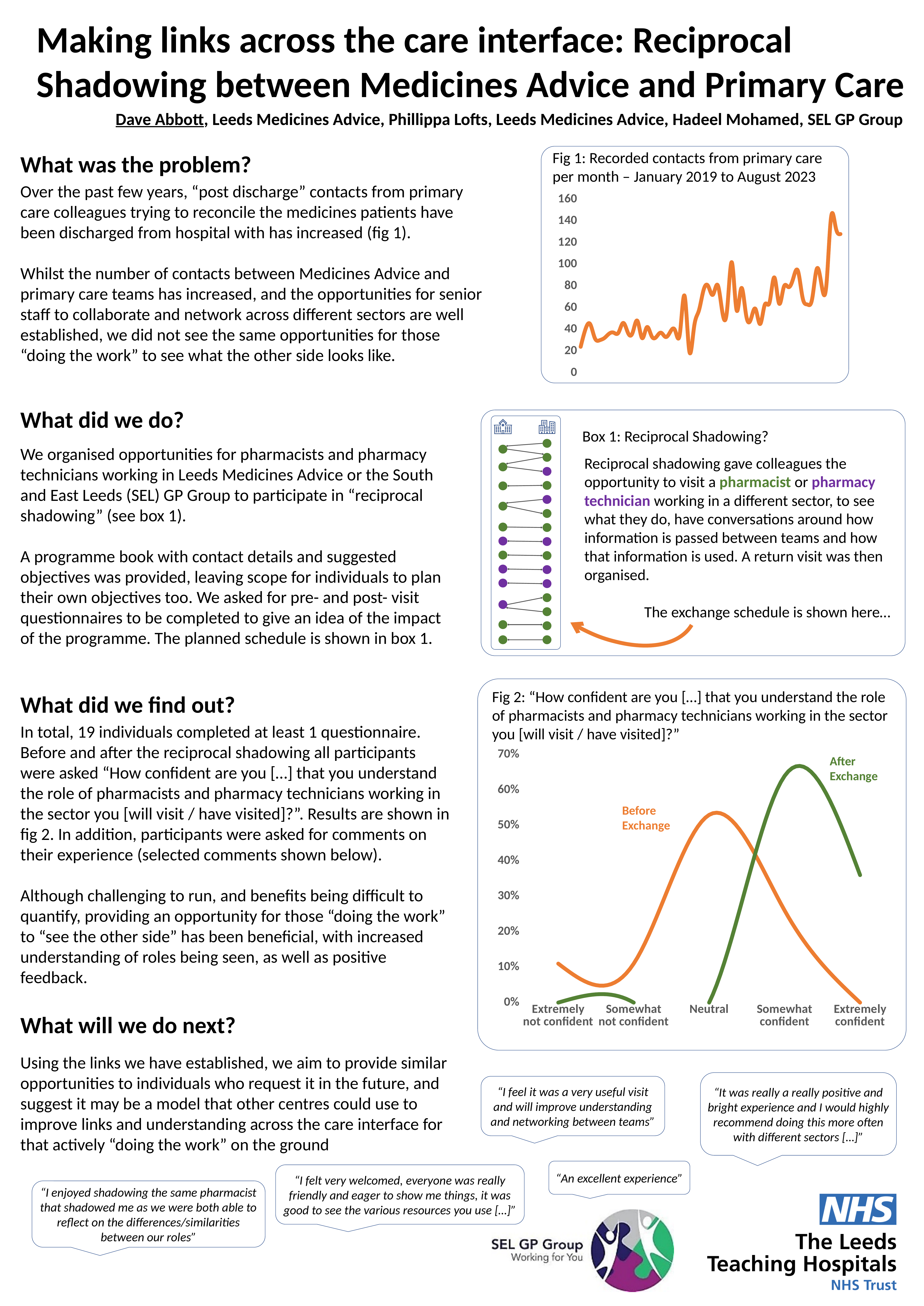
In Fig 1 (Recorded contacts from primary care per month), is the highest monthly value greater or less than 120? greater In Fig 2 (How confident are you that you understand the role of pharmacists and pharmacy technicians), which category has the highest value for After Exchange? Somewhat confident In Fig 1 (Recorded contacts from primary care per month), is the lowest monthly value greater or less than 40? less In Fig 2 (How confident are you that you understand the role of pharmacists and pharmacy technicians), is the After Exchange value for Somewhat confident greater or less than 60%? greater In Fig 2 (How confident are you that you understand the role of pharmacists and pharmacy technicians), which series has the larger value for Neutral, Before Exchange or After Exchange? Before Exchange In Fig 1 (Recorded contacts from primary care per month), do the values generally rise or fall from January 2019 to August 2023? rise In Fig 1 (Recorded contacts from primary care per month), what is the highest value shown on the vertical axis? 160 What kind of chart is Fig 1 (Recorded contacts from primary care per month)? line chart How many series are plotted in Fig 2 (How confident are you that you understand the role of pharmacists and pharmacy technicians)? 2 How many response categories are shown on the x axis of Fig 2 (How confident are you that you understand the role of pharmacists and pharmacy technicians)? 5 In Fig 2 (How confident are you that you understand the role of pharmacists and pharmacy technicians), which category has the highest value for Before Exchange? Neutral What kind of chart is Fig 2 (How confident are you that you understand the role of pharmacists and pharmacy technicians)? line chart